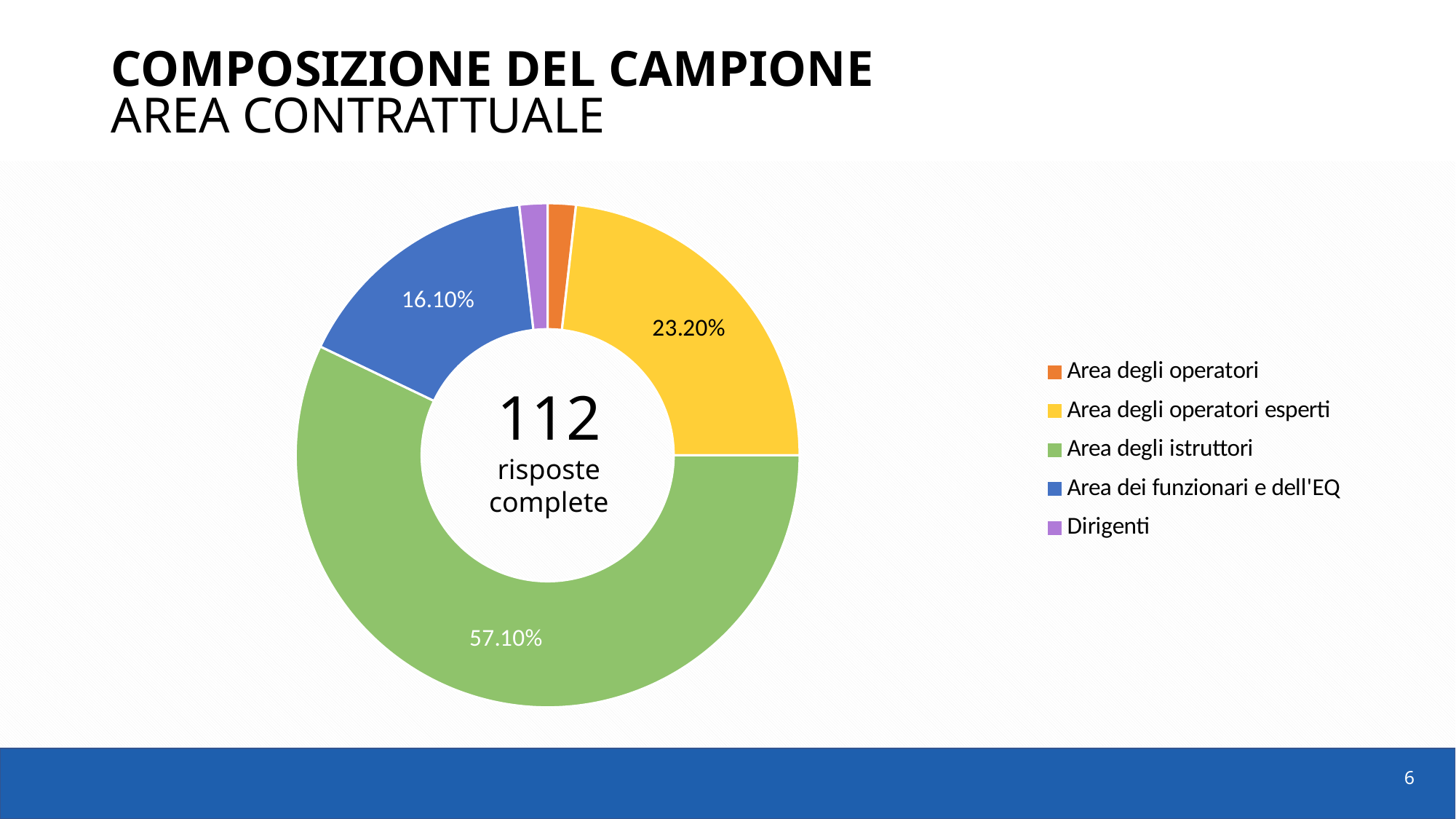
Which category is shown in orange in the legend? Area degli operatori What percentage share does Area degli istruttori have in the chart? 57.10% What percentage share does Area dei funzionari e dell'EQ have in the chart? 16.10% Which is larger: the share for Area degli istruttori or the share for Area degli operatori esperti? Area degli istruttori What number is shown in the centre of the chart? 112 What kind of chart is shown on the slide? Pie (doughnut) chart What is the difference in percentage points between the share for Area degli operatori esperti and the share for Area dei funzionari e dell'EQ? 7.10% What percentage share does Area degli operatori esperti have in the chart? 23.20% How many categories does the chart show? 5 Which is larger: the share for Area dei funzionari e dell'EQ or the share for Dirigenti? Area dei funzionari e dell'EQ Which category has the largest share of the chart? Area degli istruttori What is the difference in percentage points between the share for Area degli istruttori and the share for Area degli operatori esperti? 33.90%